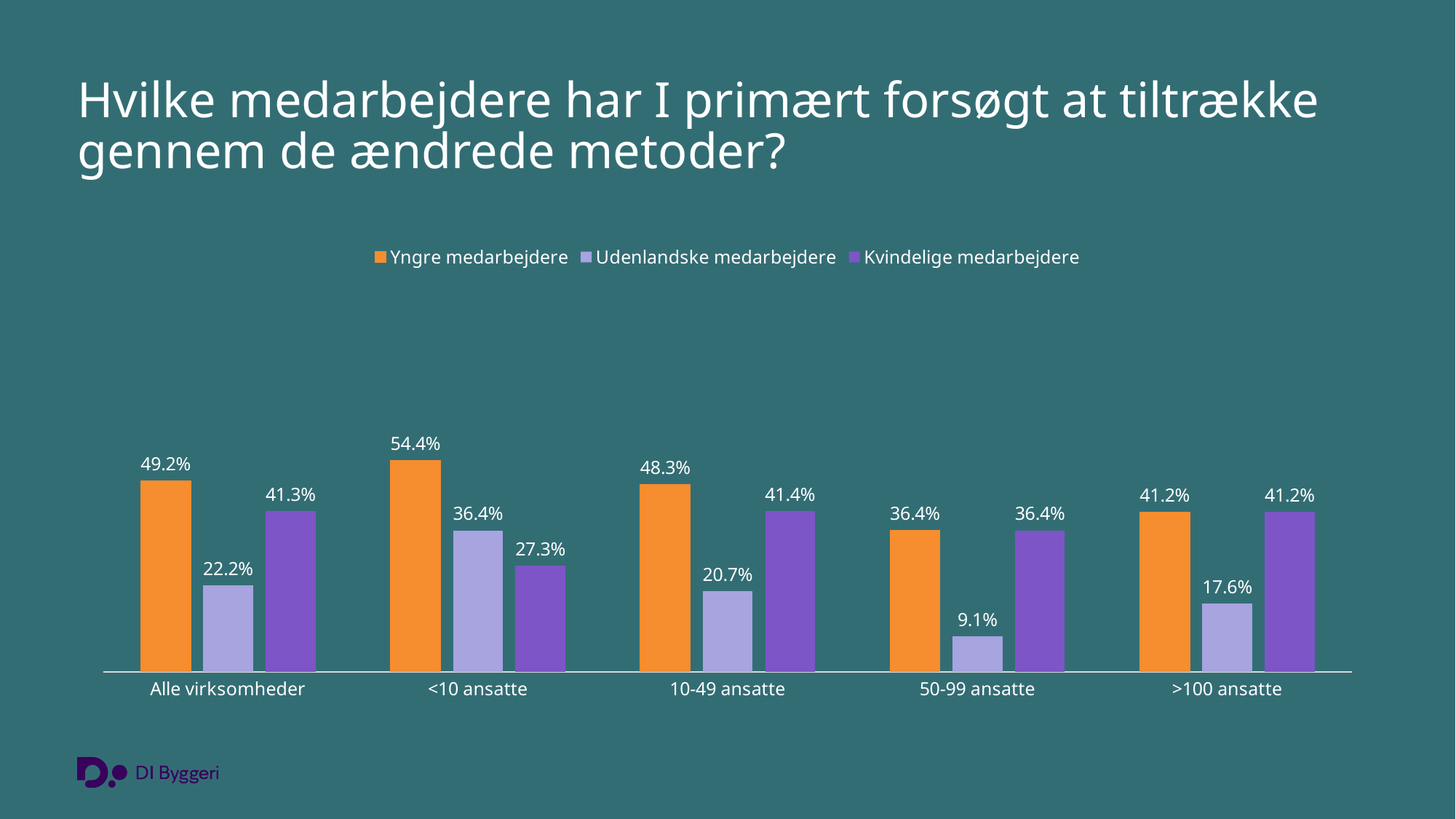
What is the difference between Yngre medarbejdere and Udenlandske medarbejdere in the 10-49 ansatte category? 27.6% What is the value for Yngre medarbejdere in the <10 ansatte category? 54.4% Which is larger in the <10 ansatte category: Udenlandske medarbejdere or Kvindelige medarbejdere? Udenlandske medarbejdere What is the value for Udenlandske medarbejdere in the >100 ansatte category? 17.6% Which series is shown in orange in the legend? Yngre medarbejdere How many categories are shown on the x axis? 5 What kind of chart is shown on the slide? Bar chart Which category has the lowest value for Udenlandske medarbejdere? 50-99 ansatte How many series does the legend list? 3 What is the value for Udenlandske medarbejdere in the 50-99 ansatte category? 9.1% What is the value for Kvindelige medarbejdere in the Alle virksomheder category? 41.3% Which category has the highest value for Yngre medarbejdere? <10 ansatte